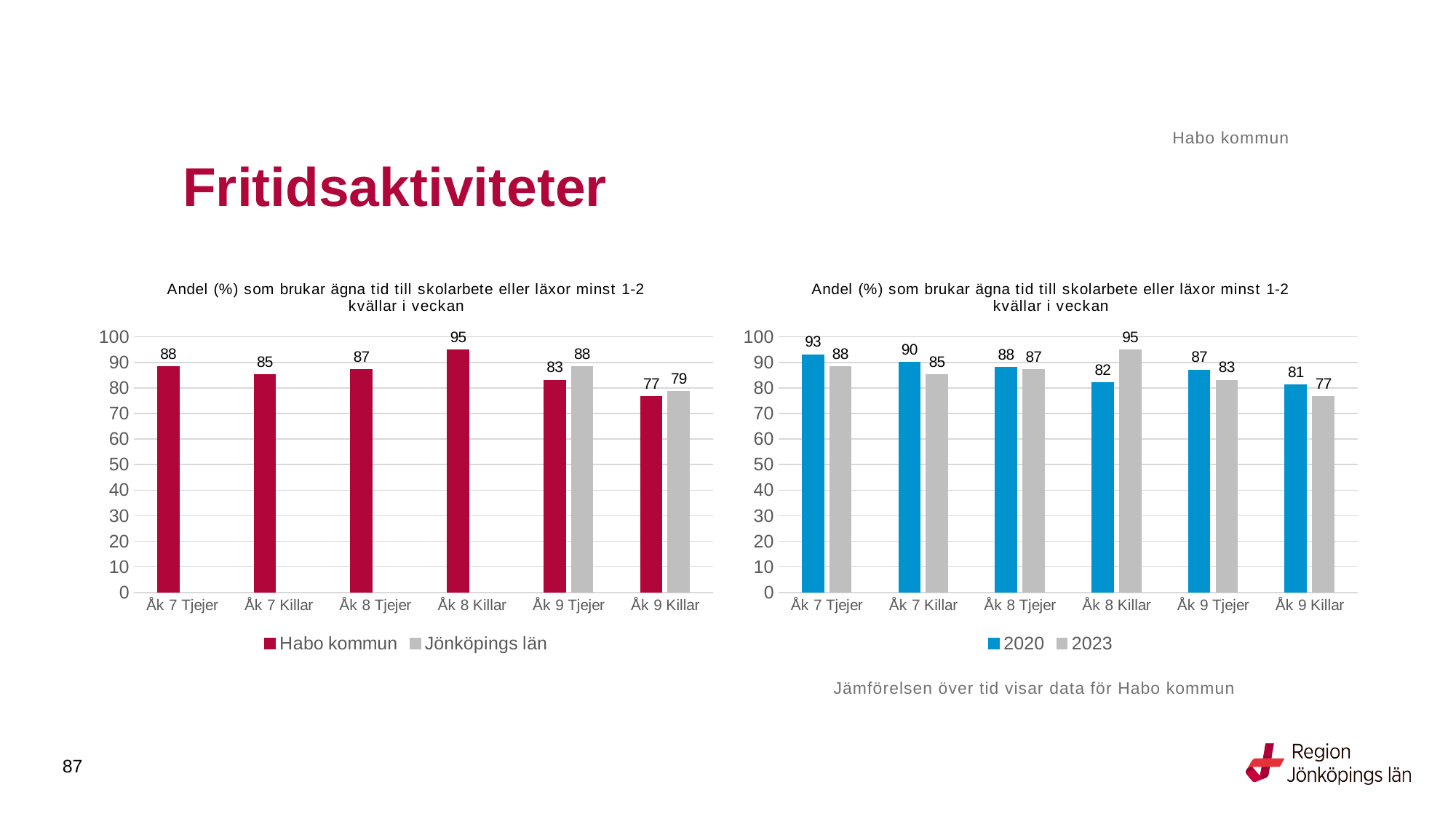
In the left chart, which category has the lowest Habo kommun value? Åk 9 Killar In the right chart, which category has the highest 2023 value? Åk 8 Killar In the right chart, what is the 2023 value for Åk 9 Killar? 77 In the right chart, what is the difference between the 2020 and 2023 values for Åk 7 Tjejer? 5 In the left chart, what is the value for Jönköpings län for Åk 9 Killar? 79 In the left chart, how many series does the legend list? 2 In the right chart, which is larger for Åk 8 Killar, the 2020 value or the 2023 value? 2023 In the left chart, what is the value for Habo kommun for Åk 8 Killar? 95 What type of chart is the left chart? Bar chart In the right chart, what is the 2020 value for Åk 7 Tjejer? 93 In the left chart, what is the difference between Habo kommun and Jönköpings län for Åk 9 Tjejer? 5 How many categories are shown on the x axis of the right chart? 6